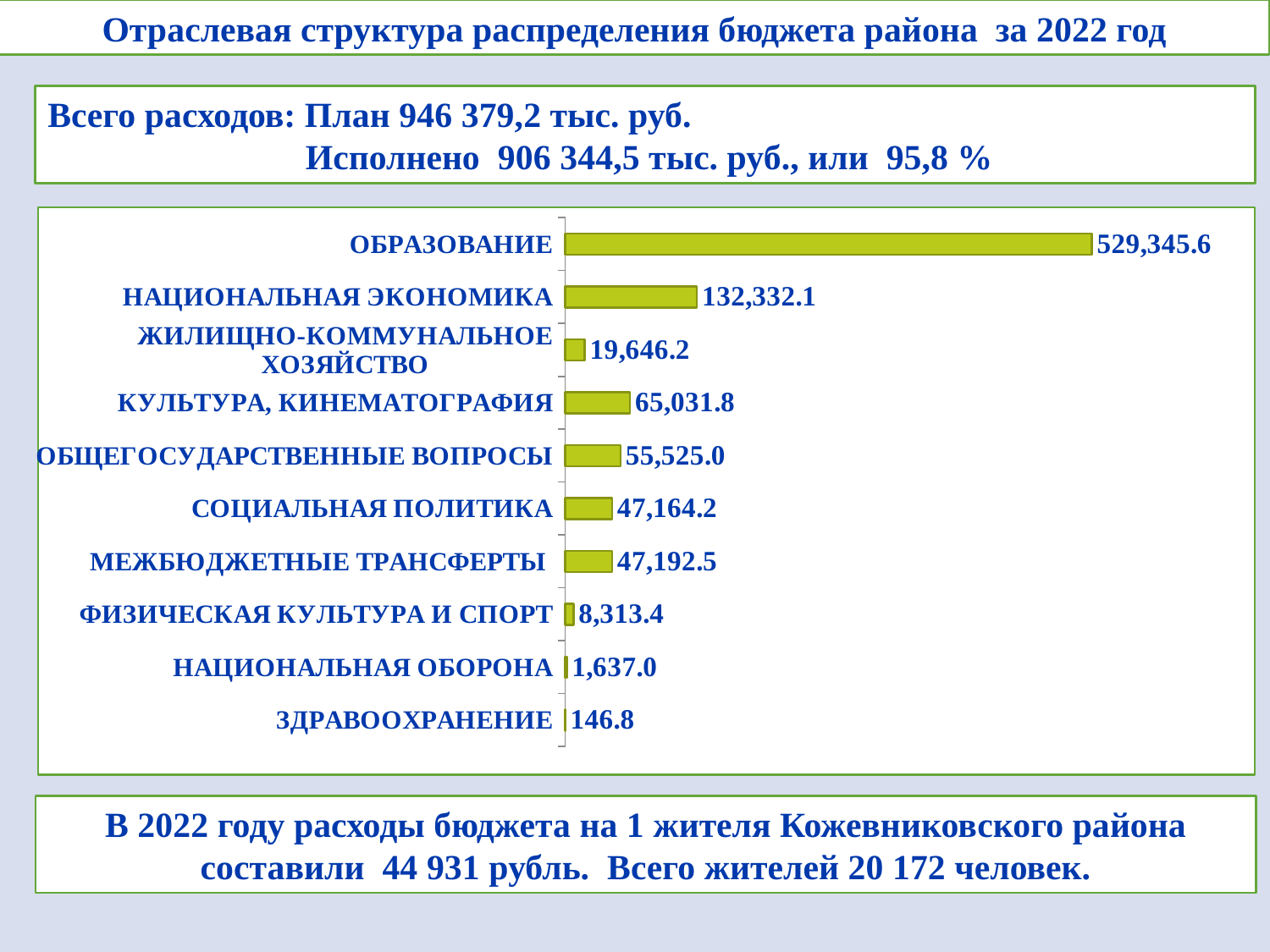
What is the difference between the values for КУЛЬТУРА, КИНЕМАТОГРАФИЯ and ОБЩЕГОСУДАРСТВЕННЫЕ ВОПРОСЫ? 9,506.8 How many categories are shown in the chart? 10 Which category has the lowest value? ЗДРАВООХРАНЕНИЕ What colour are the bars in the chart? Yellow-green What is the value for ОБРАЗОВАНИЕ? 529,345.6 What is the difference between the values for ОБРАЗОВАНИЕ and НАЦИОНАЛЬНАЯ ЭКОНОМИКА? 397,013.5 What is the value for НАЦИОНАЛЬНАЯ ЭКОНОМИКА? 132,332.1 What is the value for ЗДРАВООХРАНЕНИЕ? 146.8 What type of chart is shown on the slide? Bar chart Which category has the highest value? ОБРАЗОВАНИЕ Which is larger, the value for ФИЗИЧЕСКАЯ КУЛЬТУРА И СПОРТ or the value for НАЦИОНАЛЬНАЯ ОБОРОНА? ФИЗИЧЕСКАЯ КУЛЬТУРА И СПОРТ What is the value for ЖИЛИЩНО-КОММУНАЛЬНОЕ ХОЗЯЙСТВО? 19,646.2